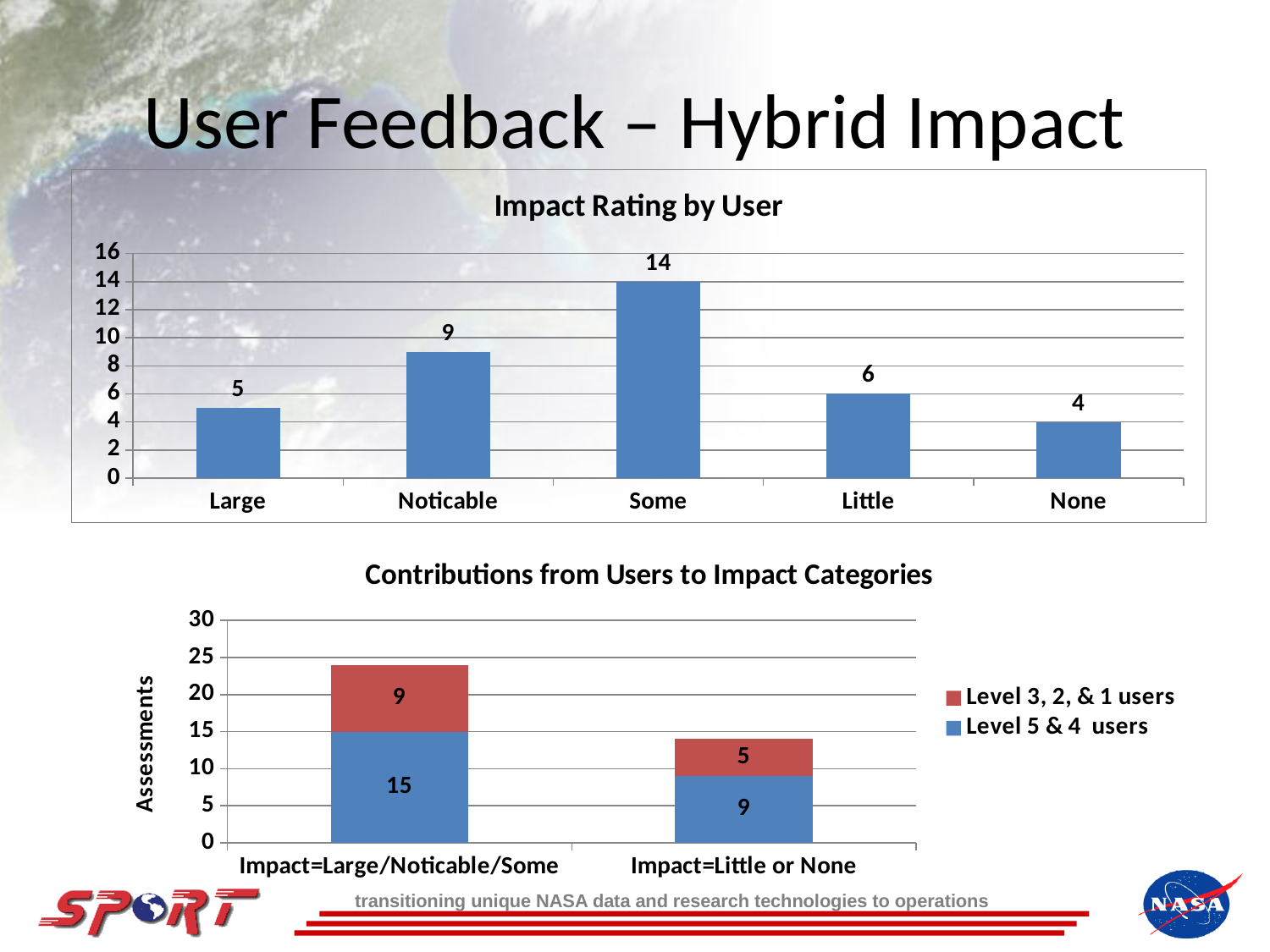
What kind of chart is the 'Contributions from Users to Impact Categories' chart? Stacked bar chart In the 'Contributions from Users to Impact Categories' chart, what is the value for Level 5 & 4 users in the Impact=Large/Noticable/Some category? 15 In the 'Impact Rating by User' chart, what is the value for Some? 14 In the 'Impact Rating by User' chart, which is larger, the value for Little or the value for None? Little In the 'Impact Rating by User' chart, how many categories are shown on the x axis? 5 In the 'Impact Rating by User' chart, what is the difference between the values for Noticable and Large? 4 In the 'Contributions from Users to Impact Categories' chart, what is the total of the stacked bar for Impact=Large/Noticable/Some? 24 How many series does the legend of the 'Contributions from Users to Impact Categories' chart list? 2 In the 'Impact Rating by User' chart, which category has the lowest value? None In the 'Contributions from Users to Impact Categories' chart, what is the total of the stacked bar for Impact=Little or None? 14 In the 'Impact Rating by User' chart, what is the value for None? 4 In the 'Impact Rating by User' chart, which category has the highest value? Some